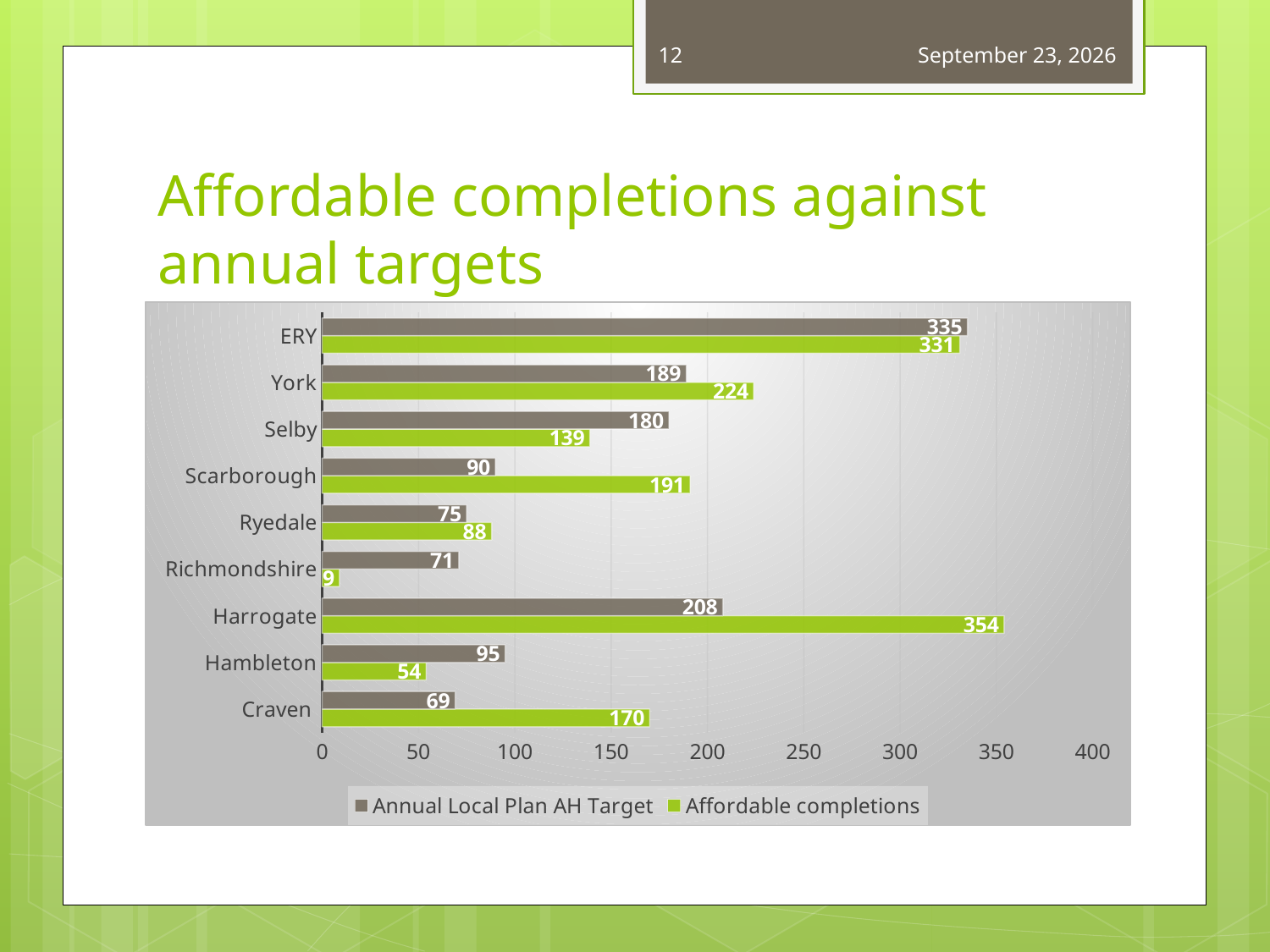
What is the Annual Local Plan AH Target for Selby? 180 Which category has the highest Affordable completions value? Harrogate What is the Affordable completions value for Richmondshire? 9 Which category has the lowest Annual Local Plan AH Target? Craven What is the Affordable completions value for Harrogate? 354 Is the Affordable completions value for York greater or less than 200? greater What kind of chart is shown on the slide? Bar chart What is the difference between the Affordable completions and the Annual Local Plan AH Target for Scarborough? 101 How many categories are shown on the chart? 9 What is the title of the slide containing the chart? Affordable completions against annual targets Which is larger for Hambleton: the Annual Local Plan AH Target or the Affordable completions? Annual Local Plan AH Target How many series does the legend list? 2